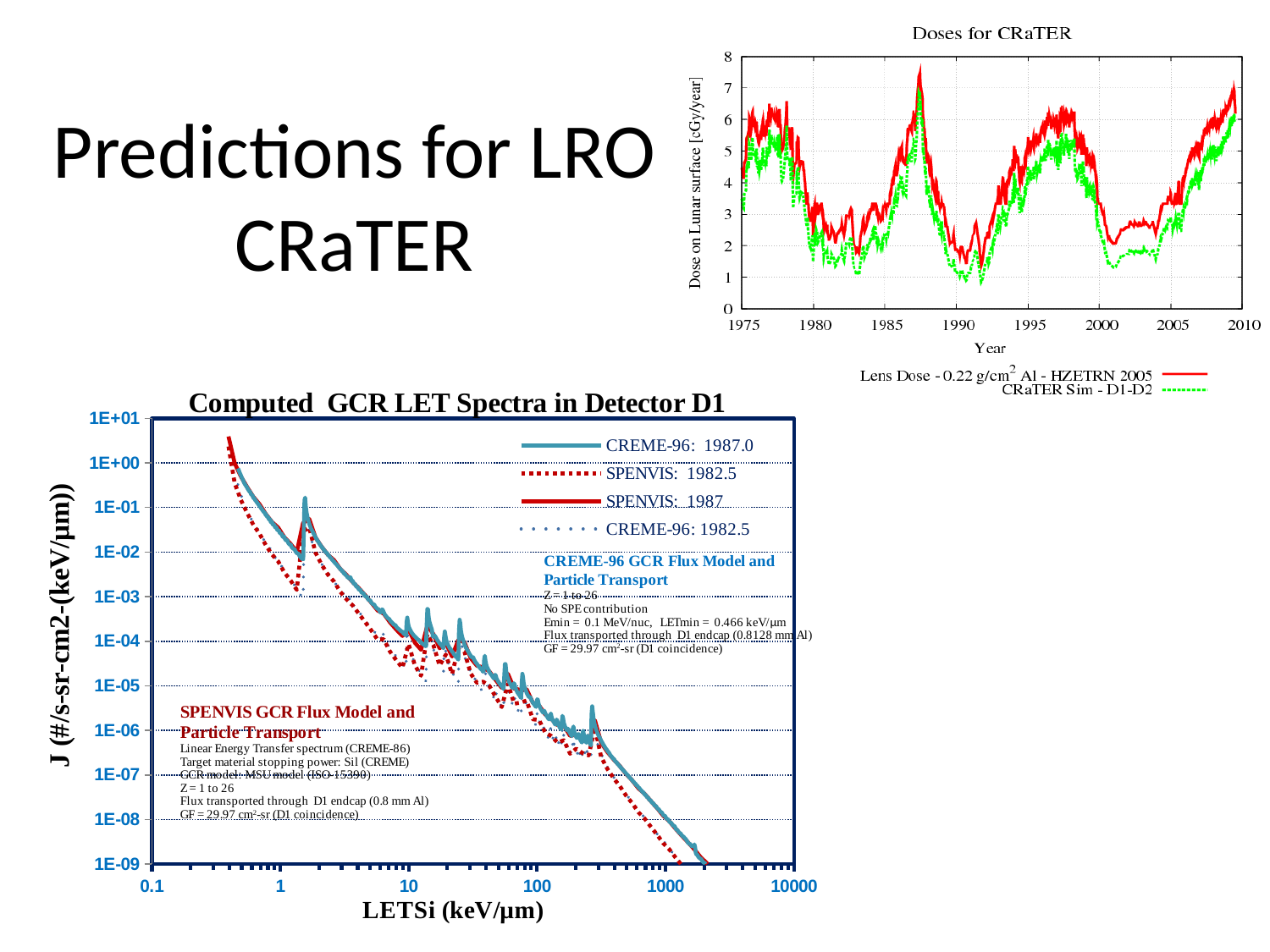
In the "Doses for CRaTER" chart, is the peak value of the Lens Dose - 0.22 g/cm² Al - HZETRN 2005 series around 1987 greater or less than 7? greater What type of chart is "Computed GCR LET Spectra in Detector D1"? line chart In the "Doses for CRaTER" chart, which series is generally higher, the Lens Dose - 0.22 g/cm² Al - HZETRN 2005 series or the CRaTER Sim - D1-D2 series? Lens Dose - 0.22 g/cm² Al - HZETRN 2005 In the "Computed GCR LET Spectra in Detector D1" chart, what is the label of the x axis? LETSi (keV/µm) How many series does the legend of the "Doses for CRaTER" chart list? 2 What type of chart is the "Doses for CRaTER" chart? line chart In the "Computed GCR LET Spectra in Detector D1" chart, is the value of the CREME-96: 1987.0 series at LETSi = 10 keV/µm greater or less than 1E-02? less In the "Computed GCR LET Spectra in Detector D1" chart, is the value of the CREME-96: 1987.0 series at LETSi = 1000 keV/µm greater or less than 1E-06? less How many series does the legend of the "Computed GCR LET Spectra in Detector D1" chart list? 4 In the "Computed GCR LET Spectra in Detector D1" chart, do the values generally rise or fall as LETSi increases? fall In the "Doses for CRaTER" chart, what is the label of the x axis? Year